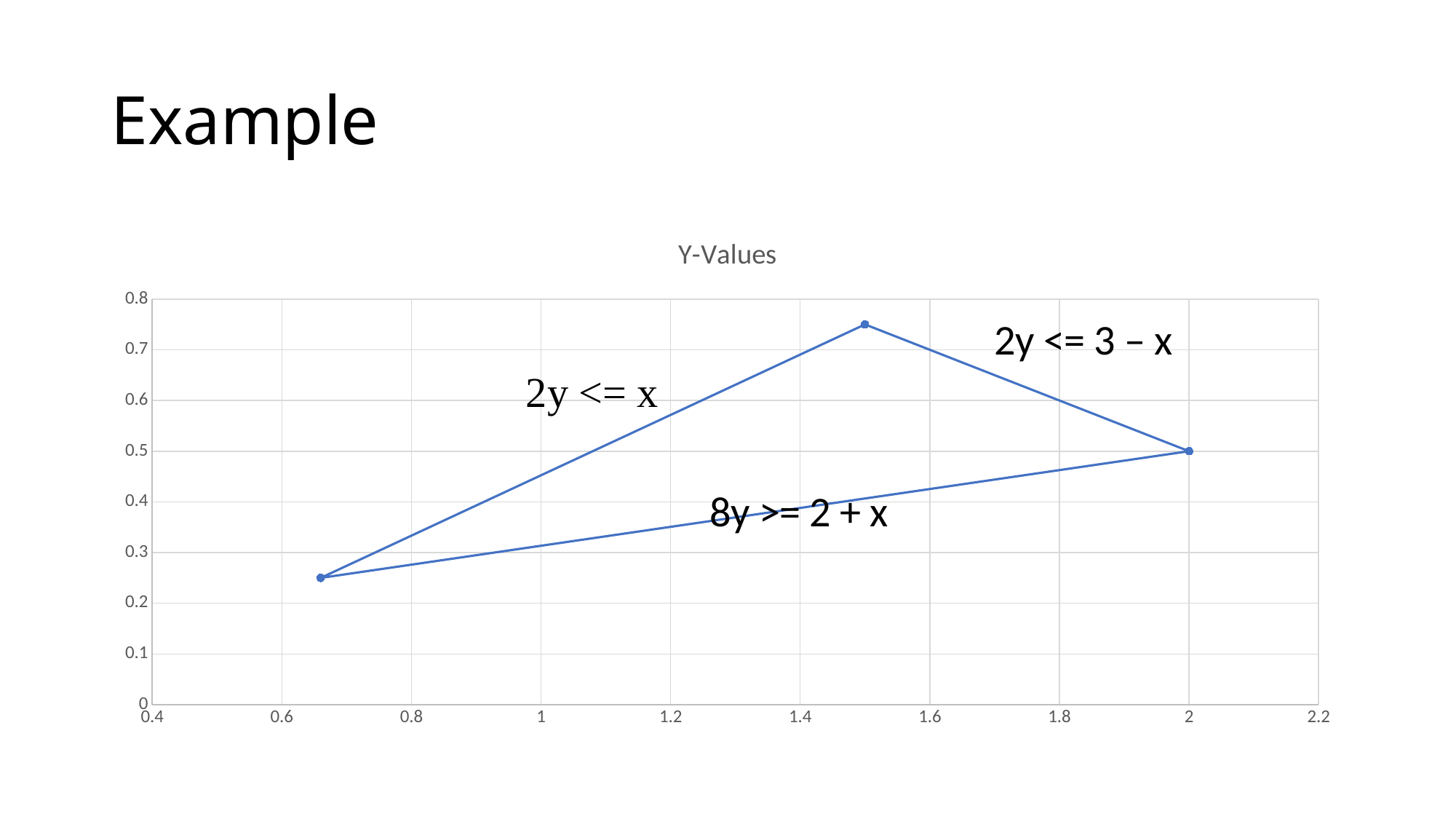
What kind of chart is shown on the slide? scatter chart Which inequality labels the edge between the highest point and the point at x = 2? 2y <= 3 – x Which has the larger y value: the point at x = 2 or the leftmost point? the point at x = 2 How many marked data points (vertices) are plotted on the chart? 3 What is the y value of the point plotted at x = 2? 0.5 What is the title of the chart? Y-Values Is the y value of the highest point on the chart greater or less than 0.7? greater Is the x value of the leftmost point greater or less than 0.6? greater Is the x value of the highest point on the chart greater or less than 1.4? greater